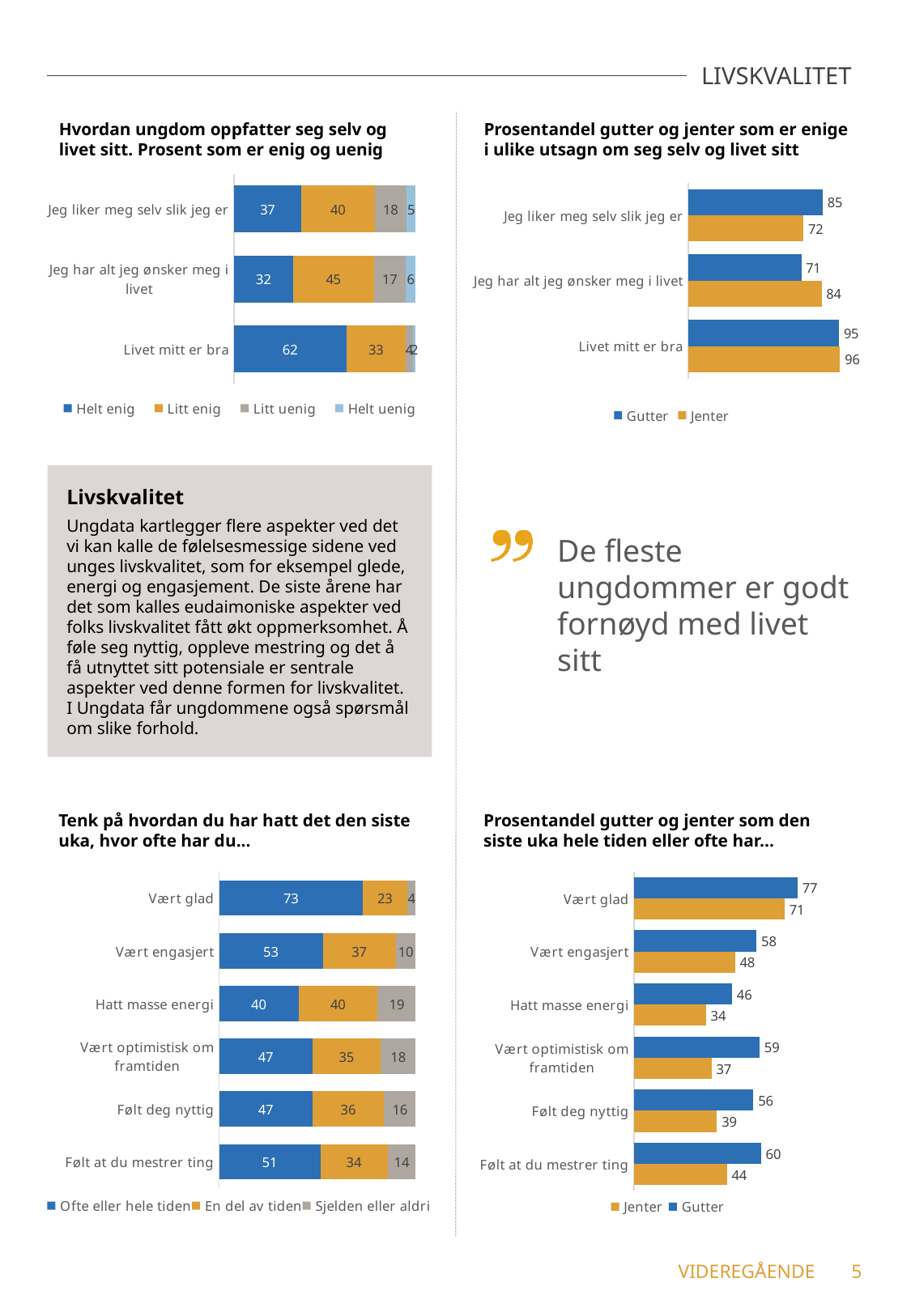
In the bottom-left chart 'Tenk på hvordan du har hatt det den siste uka, hvor ofte har du…', what is the 'Ofte eller hele tiden' value for 'Vært engasjert'? 53 In the top-right chart 'Prosentandel gutter og jenter som er enige i ulike utsagn om seg selv og livet sitt', which statement has the highest Gutter value? Livet mitt er bra What kind of chart is the bottom-right chart 'Prosentandel gutter og jenter som den siste uka hele tiden eller ofte har…'? Bar chart In the top-right chart 'Prosentandel gutter og jenter som er enige i ulike utsagn om seg selv og livet sitt', what is the Jenter value for 'Jeg har alt jeg ønsker meg i livet'? 84 In the bottom-left chart 'Tenk på hvordan du har hatt det den siste uka, hvor ofte har du…', which category has the lowest 'Ofte eller hele tiden' value? Hatt masse energi In the bottom-right chart 'Prosentandel gutter og jenter som den siste uka hele tiden eller ofte har…', what is the Jenter value for 'Hatt masse energi'? 34 In the bottom-left chart 'Tenk på hvordan du har hatt det den siste uka, hvor ofte har du…', how many categories are shown? 6 In the top-left chart 'Hvordan ungdom oppfatter seg selv og livet sitt', how many series does the legend list? 4 In the bottom-right chart 'Prosentandel gutter og jenter som den siste uka hele tiden eller ofte har…', what is the difference between the Gutter and Jenter values for 'Vært optimistisk om framtiden'? 22 In the top-left chart 'Hvordan ungdom oppfatter seg selv og livet sitt', what is the difference between the 'Litt enig' values for 'Jeg har alt jeg ønsker meg i livet' and 'Jeg liker meg selv slik jeg er'? 5 In the top-left chart 'Hvordan ungdom oppfatter seg selv og livet sitt', what is the 'Helt enig' value for 'Livet mitt er bra'? 62 In the top-right chart 'Prosentandel gutter og jenter som er enige i ulike utsagn om seg selv og livet sitt', which is larger for 'Jeg liker meg selv slik jeg er': Gutter or Jenter? Gutter